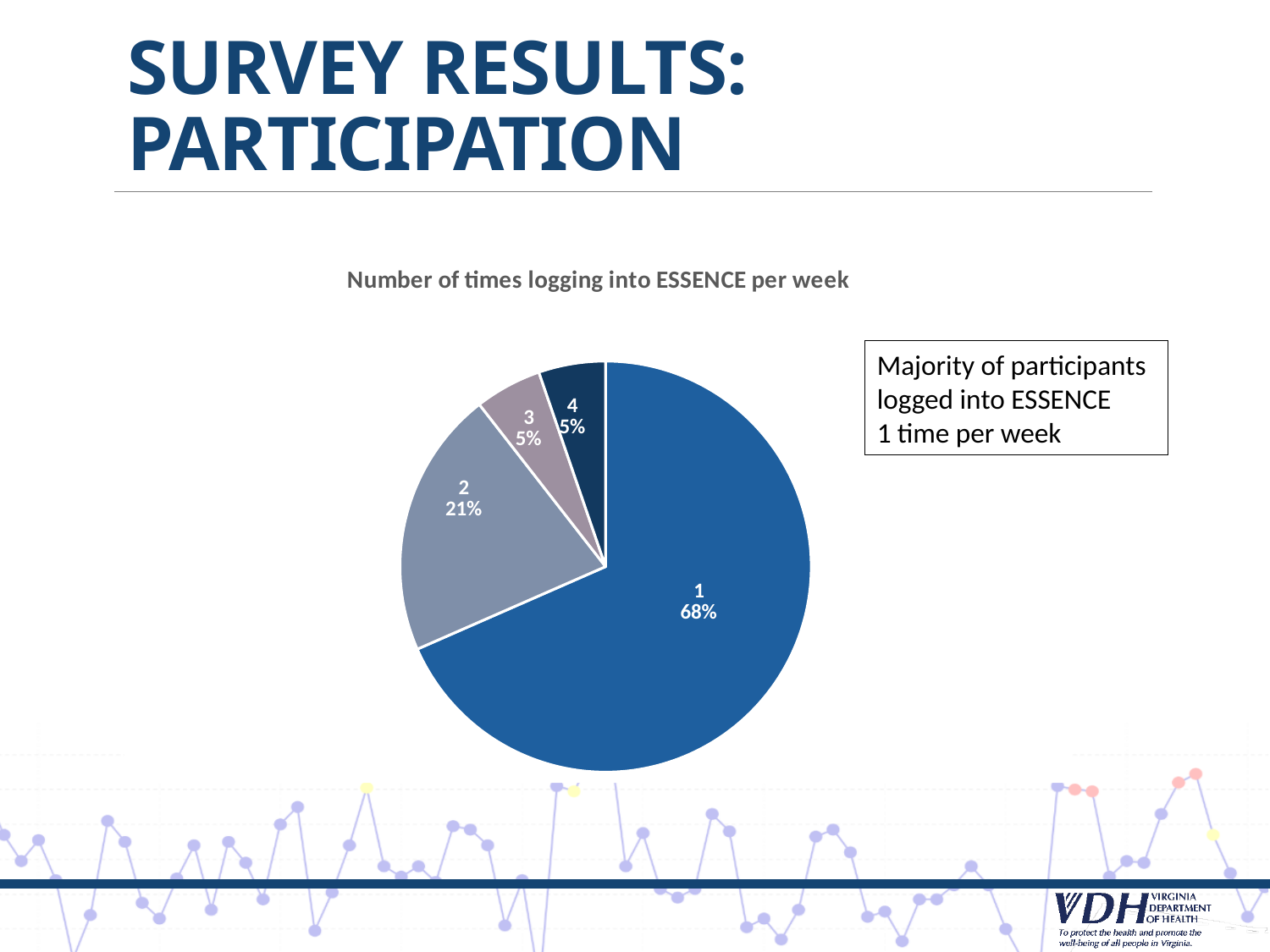
What is the difference in percentage points between the slices for "1" and "2"? 47 What share of the pie does the category "2" represent? 21% What is the title of the chart? Number of times logging into ESSENCE per week What share of the pie does the category "1" represent? 68% Which category has the largest slice of the pie? 1 What type of chart is shown on the slide? pie chart Which slice is larger, the one for "2" or the one for "3"? 2 What is the combined share of the slices for "3" and "4"? 10% How many slices does the pie chart have? 4 What share of the pie does the category "3" represent? 5% Is the share for category "2" greater or less than 50%? less